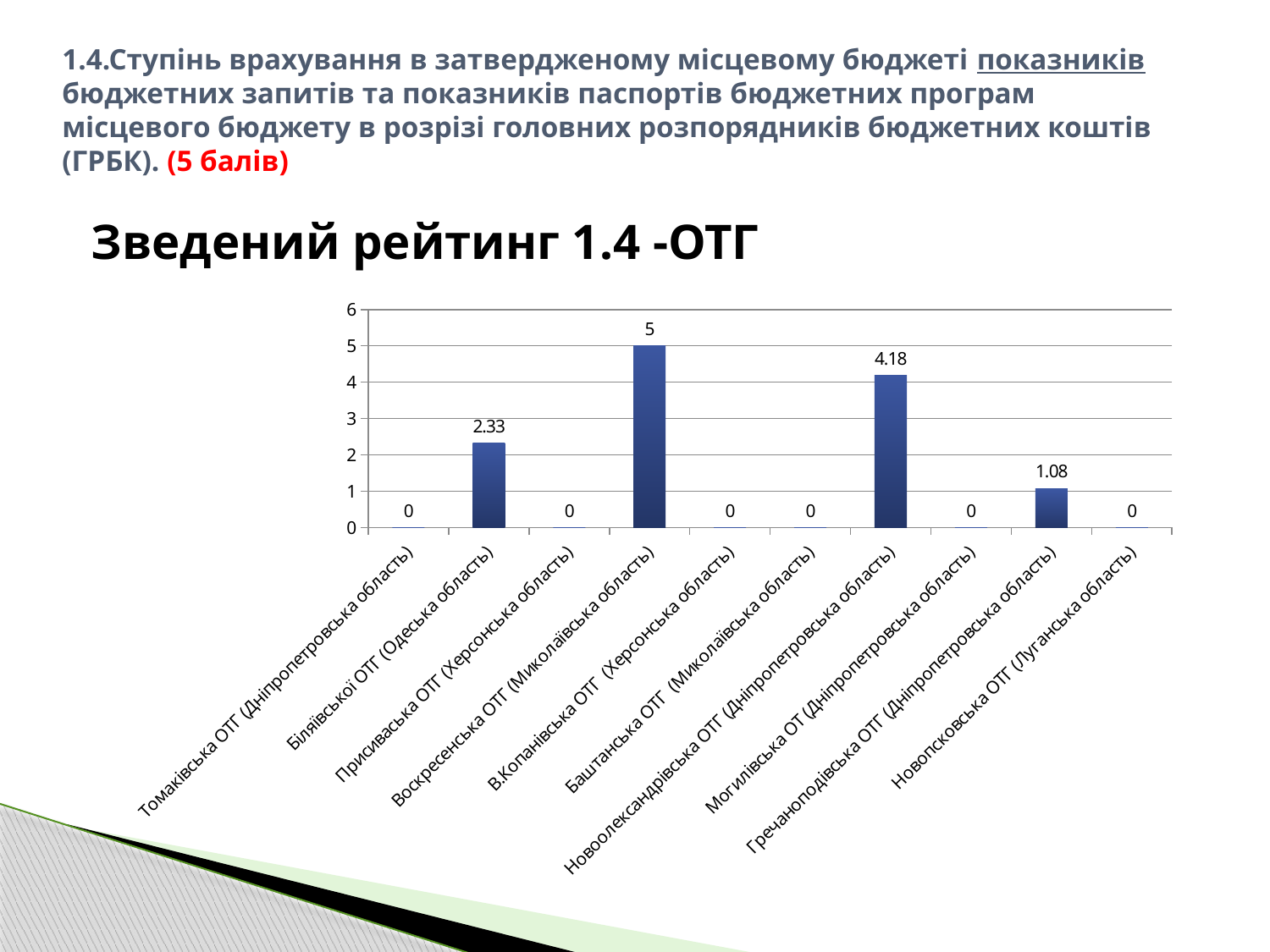
What is the value for Новоолександрівська ОТГ (Дніпропетровська область)? 4.18 Which category has the highest value? Воскресенська ОТГ (Миколаївська область) What is the value for Воскресенська ОТГ (Миколаївська область)? 5 What is the difference between the values for Воскресенська ОТГ (Миколаївська область) and Новоолександрівська ОТГ (Дніпропетровська область)? 0.82 What is the value for Біляївської ОТГ (Одеська область)? 2.33 Which is larger, the value for Біляївської ОТГ (Одеська область) or the value for Новоолександрівська ОТГ (Дніпропетровська область)? Новоолександрівська ОТГ (Дніпропетровська область) What is the value for Гречаноподівська ОТГ (Дніпропетровська область)? 1.08 What is the title of the chart? Зведений рейтинг 1.4 -ОТГ What kind of chart is shown on the slide? bar chart What is the difference between the values for Біляївської ОТГ (Одеська область) and Гречаноподівська ОТГ (Дніпропетровська область)? 1.25 What is the value for Томаківська ОТГ (Дніпропетровська область)? 0 How many categories are shown on the x axis? 10